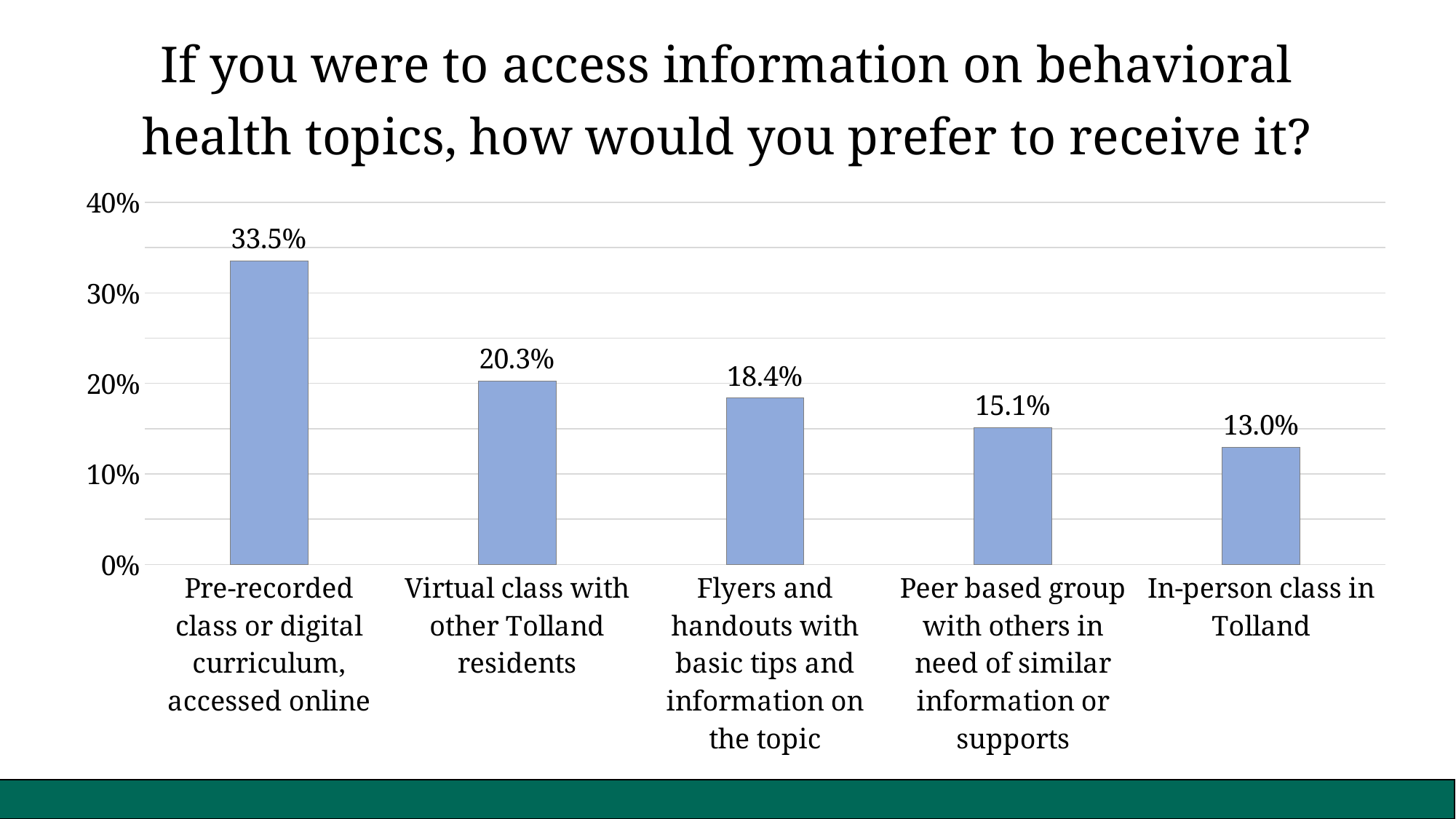
What percentage of respondents preferred a pre-recorded class or digital curriculum, accessed online? 33.5% Do the values rise or fall from left to right across the chart? Fall What is the value for 'In-person class in Tolland'? 13.0% What is the difference between the pre-recorded class option and the virtual class option? 13.2% What is the difference between the peer based group option and the in-person class option? 2.1% What is the value for 'Virtual class with other Tolland residents'? 20.3% What percentage preferred flyers and handouts with basic tips and information on the topic? 18.4% How many options are shown on the chart? 5 Which is larger: the value for flyers and handouts or the value for peer based group? Flyers and handouts with basic tips and information on the topic Which option has the highest percentage? Pre-recorded class or digital curriculum, accessed online What kind of chart is shown on the slide? Bar chart Which option has the lowest percentage? In-person class in Tolland